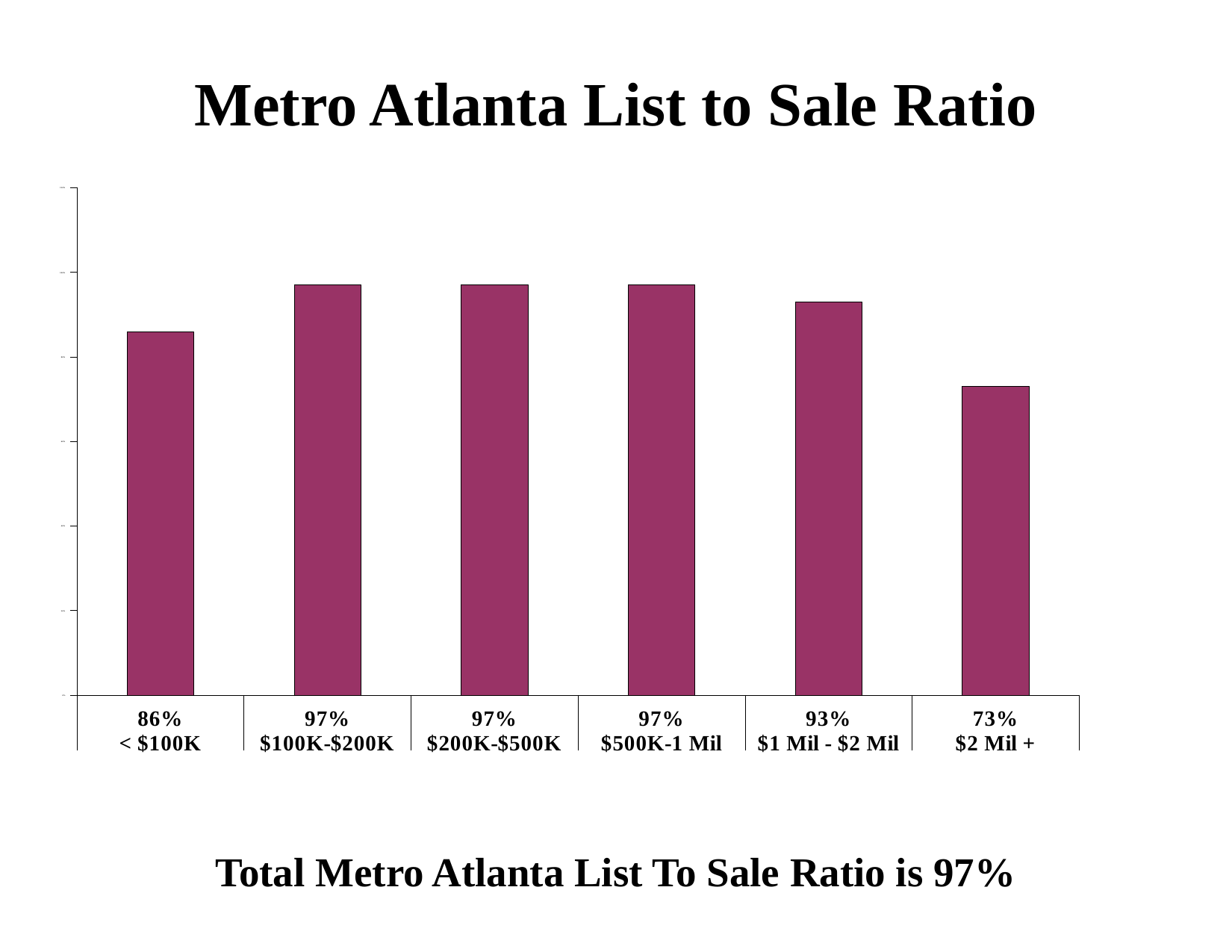
What is the difference between the list to sale ratio for $1 Mil - $2 Mil and for < $100K? 7% What is the title of the chart? Metro Atlanta List to Sale Ratio According to the text below the chart, what is the total Metro Atlanta list to sale ratio? 97% What kind of chart is shown on the slide? Bar chart What is the list to sale ratio for the $2 Mil + price range? 73% Which price range has the lowest list to sale ratio? $2 Mil + Which has a higher list to sale ratio, < $100K or $1 Mil - $2 Mil? $1 Mil - $2 Mil What is the list to sale ratio for the $1 Mil - $2 Mil price range? 93% What is the difference between the list to sale ratio for $500K-1 Mil and for $2 Mil +? 24% How many price ranges are shown in the chart? 6 What is the list to sale ratio for the $100K-$200K price range? 97% What is the list to sale ratio for the < $100K price range? 86%